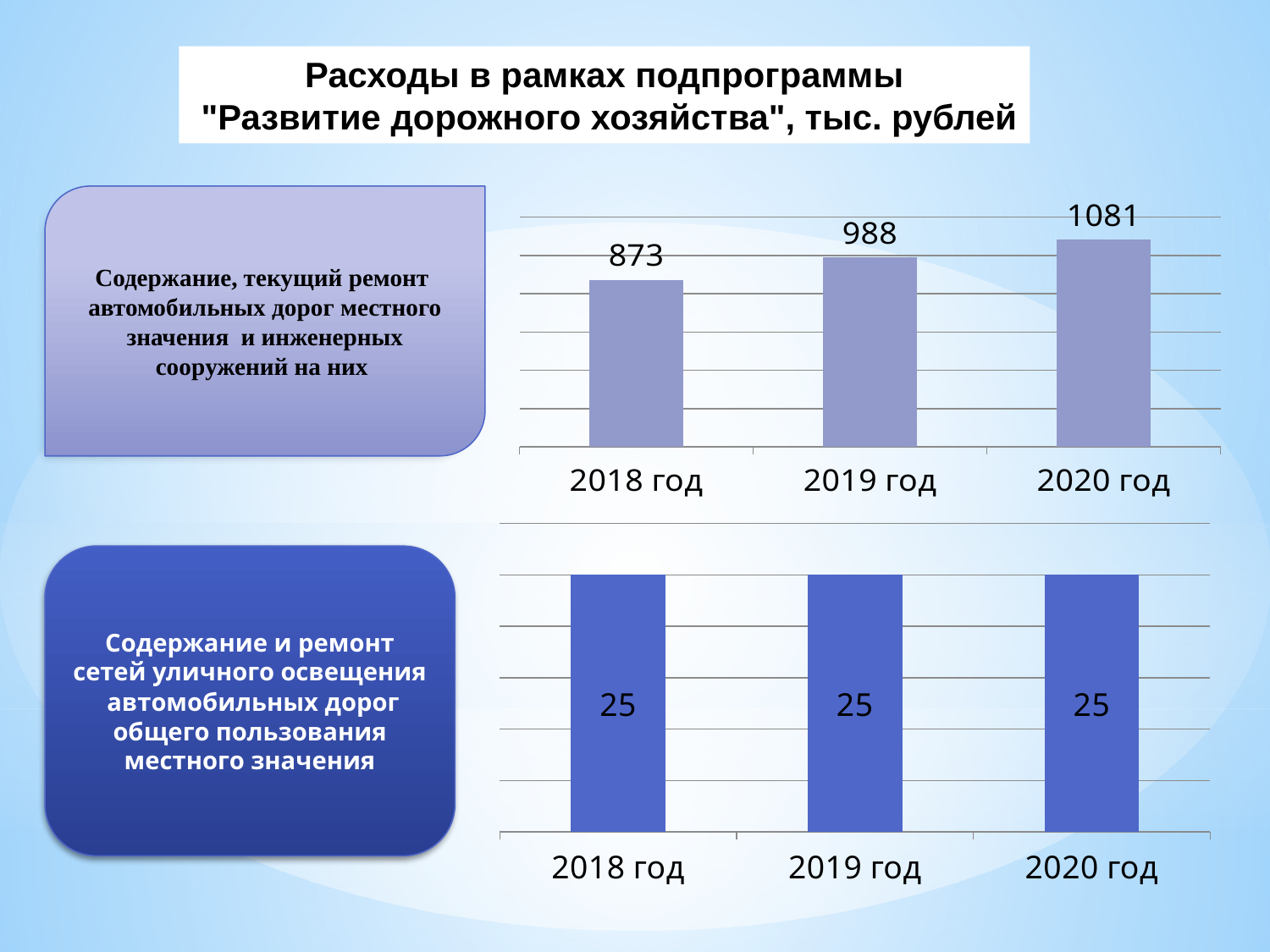
In the bottom chart (street lighting), how many years are shown? 3 In the top chart (road maintenance), what is the value for 2019 год? 988 In the top chart (road maintenance), what is the value for 2018 год? 873 In the top chart (road maintenance), do the values rise or fall from 2018 год to 2020 год? rise In the bottom chart (street lighting), do the values rise, fall or stay the same across the years? stay the same In the top chart (road maintenance), what is the difference between the values for 2020 год and 2018 год? 208 In the top chart (road maintenance), which is larger, the value for 2019 год or 2018 год? 2019 год In the top chart (road maintenance), what is the value for 2020 год? 1081 What kind of chart is the top chart on the slide? bar chart In the bottom chart (street lighting), what is the value for 2019 год? 25 In the top chart (road maintenance), which year has the lowest value? 2018 год In the top chart (road maintenance), which year has the highest value? 2020 год